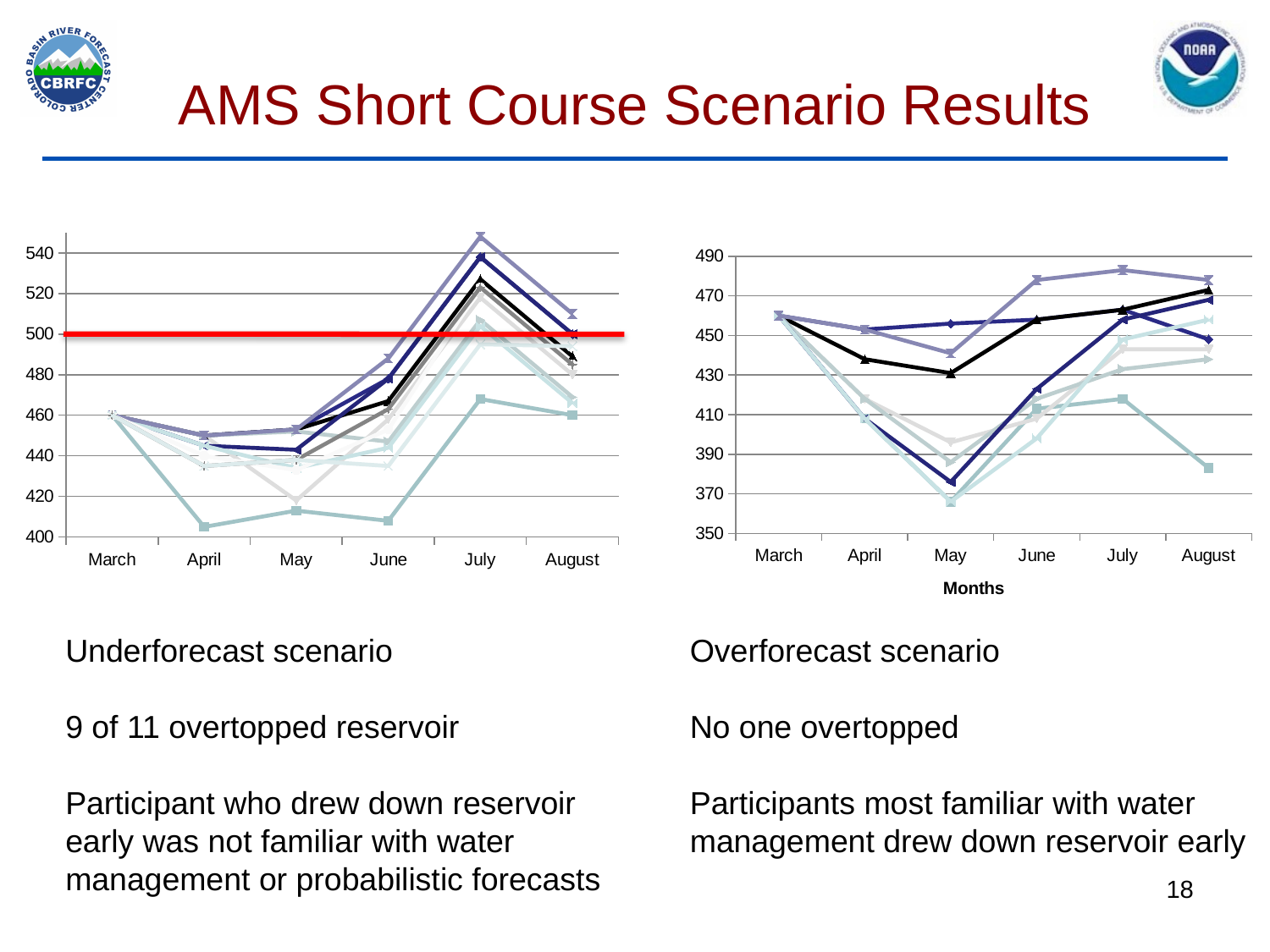
What is the x-axis title of the right chart? Months In the left chart, do the lines generally rise or fall from May to July? rise In the left chart, at what value is the red horizontal line drawn? 500 In the right chart, is the highest value in July greater or less than 470? greater In the left chart, what value do all the lines share in March? 460 What kind of chart is the left chart (Underforecast scenario)? Line chart How many months are shown on the x axis of the right chart? 6 In the right chart, is the lowest value in May greater or less than 390? less In the left chart, is the highest value in July greater or less than 540? greater What kind of chart is the right chart (Overforecast scenario)? Line chart How many months are shown on the x axis of the left chart? 6